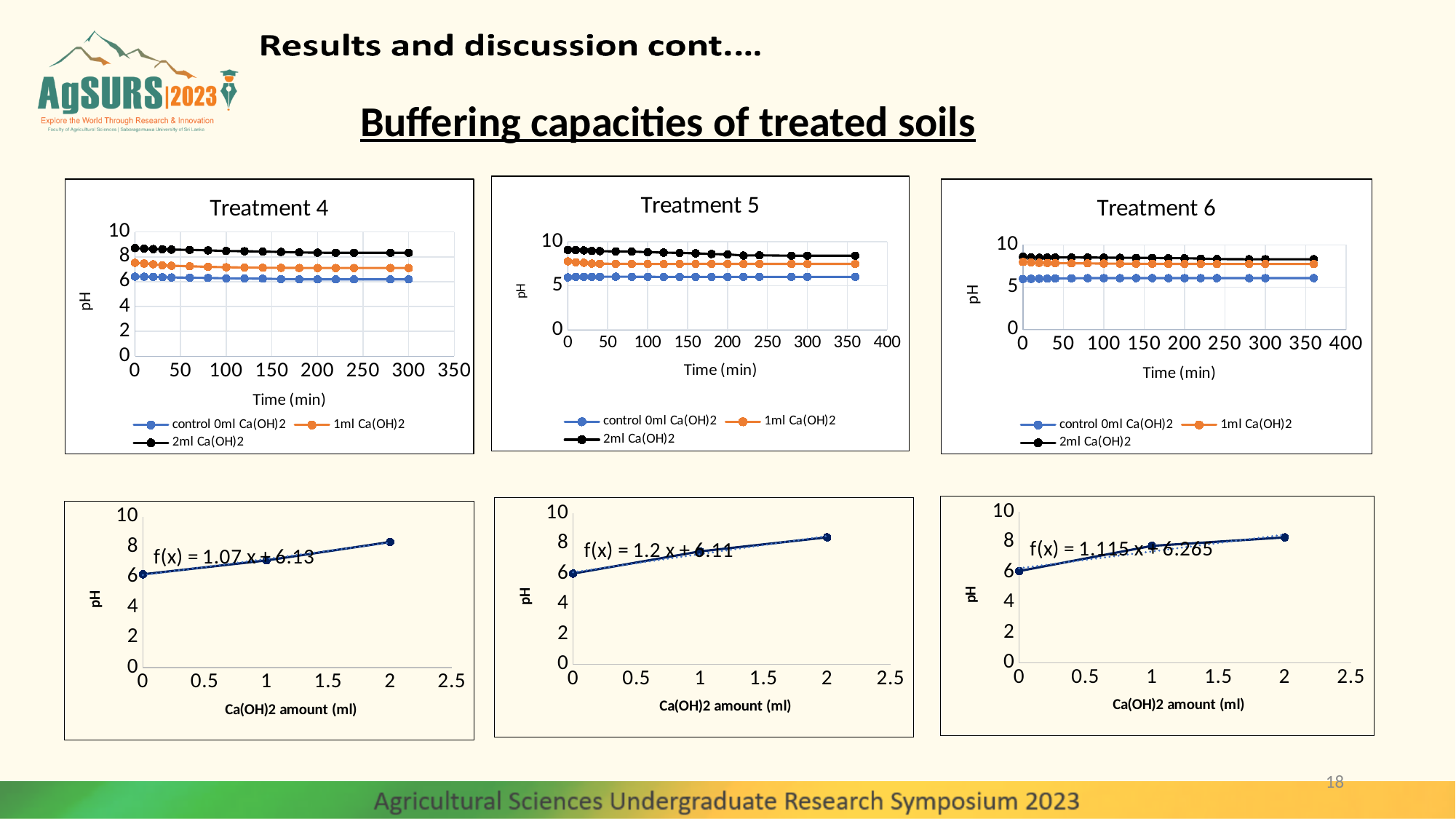
In the Treatment 6 chart, which series has the lowest pH values? control 0ml Ca(OH)2 What kind of chart is the Treatment 4 chart? line chart What is the x-axis title of the Treatment 6 chart? Time (min) What trendline equation is shown on the bottom-left chart? f(x) = 1.07 x + 6.13 In the Treatment 4 chart, does the 2ml Ca(OH)2 line rise or fall as time increases? fall How many data points are plotted on the bottom-middle chart? 3 In the bottom-right chart, does pH rise or fall as the Ca(OH)2 amount increases? rise In the Treatment 4 chart, is the pH of the control 0ml Ca(OH)2 series at time 0 greater or less than 8? less In the Treatment 4 chart, which series has the highest pH values? 2ml Ca(OH)2 How many series does the legend of the Treatment 5 chart list? 3 In the Treatment 5 chart, is the pH of the 2ml Ca(OH)2 series at time 0 greater or less than 5? greater In the Treatment 5 chart, which series has higher pH at time 0: 1ml Ca(OH)2 or control 0ml Ca(OH)2? 1ml Ca(OH)2